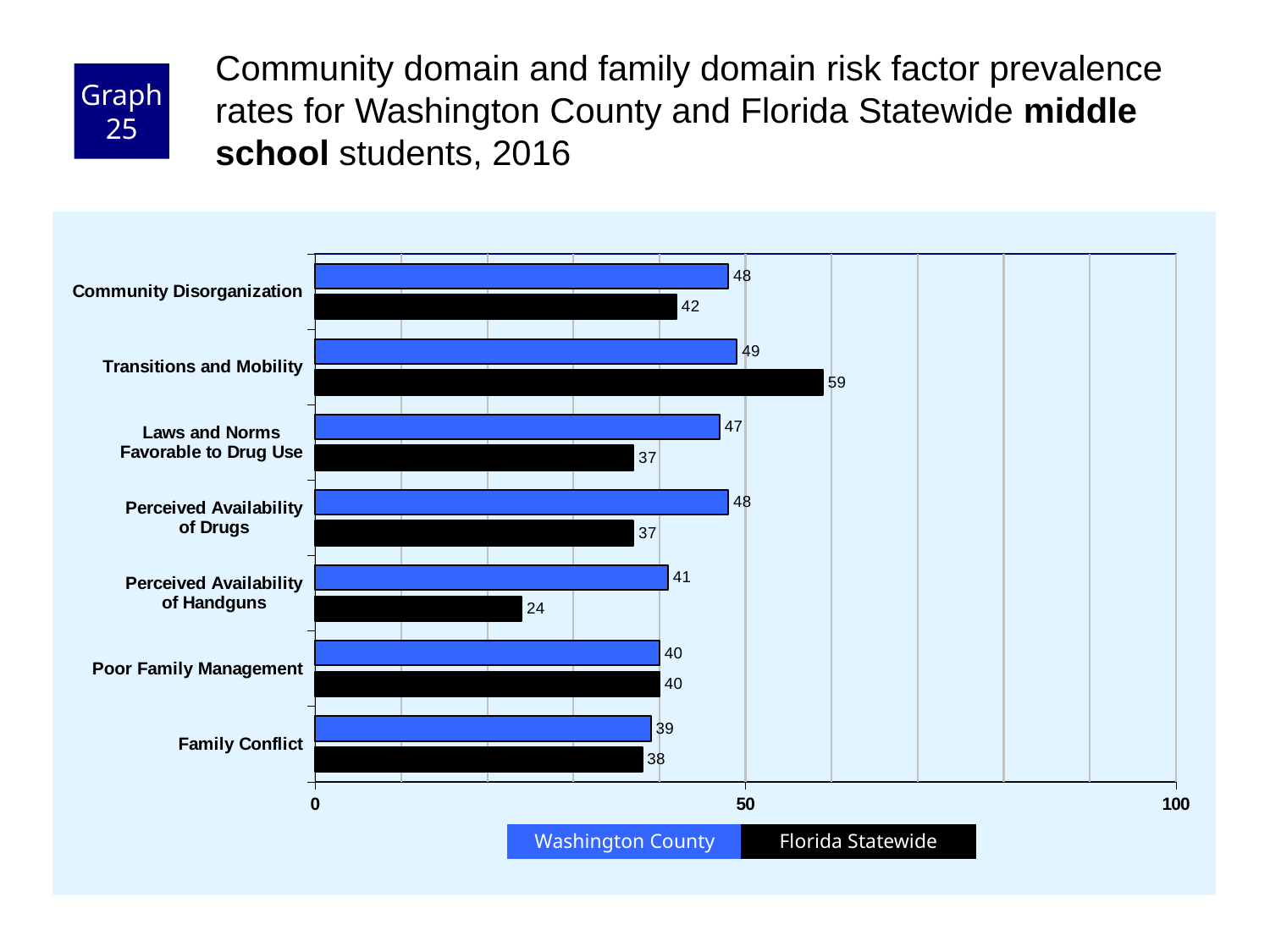
Which is larger for Laws and Norms Favorable to Drug Use: the Washington County value or the Florida Statewide value? Washington County What is the difference between the Washington County and Florida Statewide values for Perceived Availability of Handguns? 17 What is the Florida Statewide value for Community Disorganization? 42 How many series does the legend list? 2 What kind of chart is shown on the slide? Bar chart How many risk factor categories are shown on the chart? 7 Which category has the lowest Florida Statewide value? Perceived Availability of Handguns What is the difference between the Florida Statewide and Washington County values for Transitions and Mobility? 10 Which category has the lowest Washington County value? Family Conflict What is the Washington County value for Transitions and Mobility? 49 Which category has the highest Florida Statewide value? Transitions and Mobility What is the Florida Statewide value for Perceived Availability of Handguns? 24